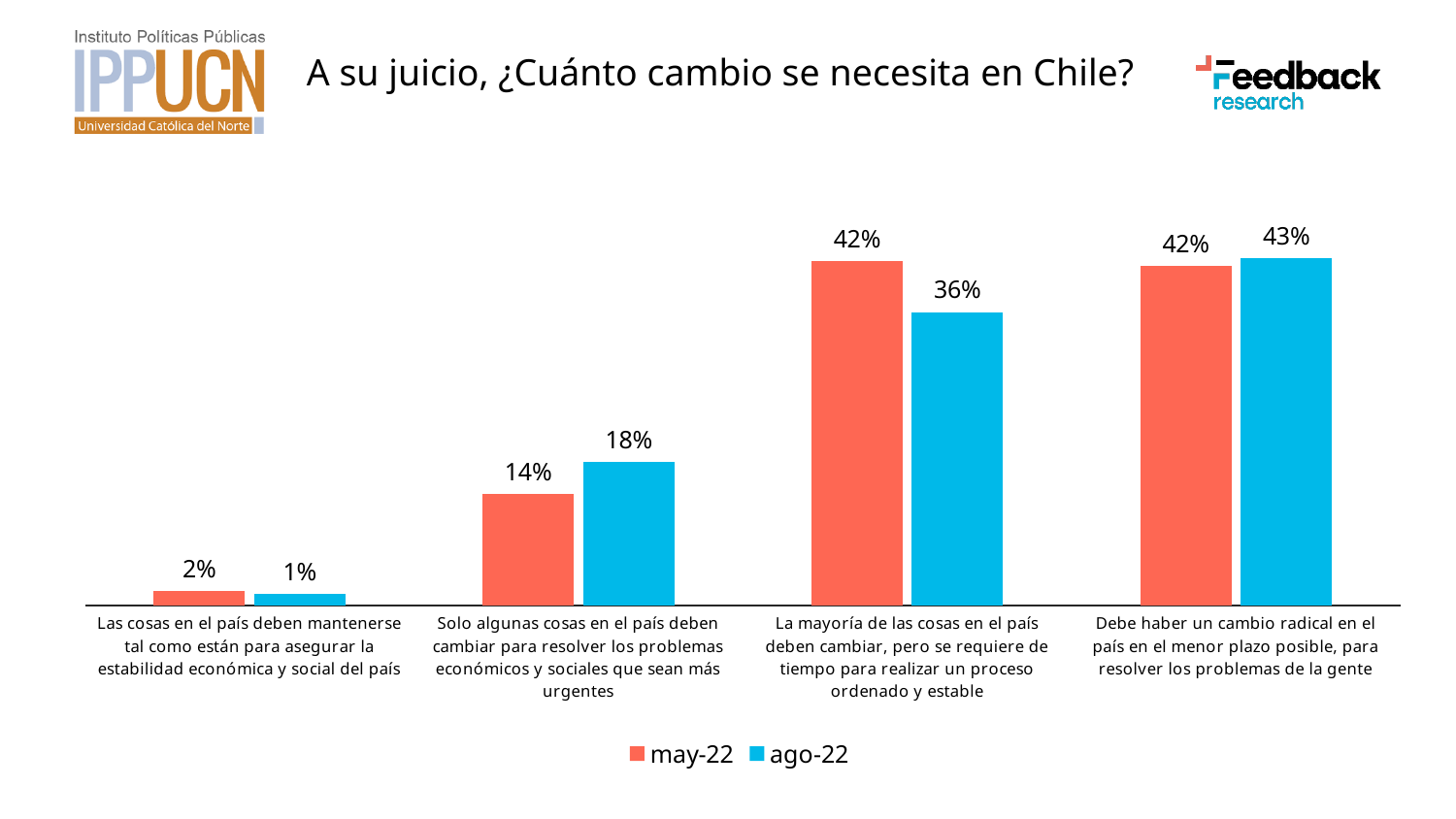
What is the ago-22 value for 'La mayoría de las cosas en el país deben cambiar, pero se requiere de tiempo para realizar un proceso ordenado y estable'? 36% What is the may-22 value for 'Debe haber un cambio radical en el país en el menor plazo posible, para resolver los problemas de la gente'? 42% Which category has the lowest ago-22 value? Las cosas en el país deben mantenerse tal como están para asegurar la estabilidad económica y social del país What is the difference between the may-22 and ago-22 values for 'La mayoría de las cosas en el país deben cambiar, pero se requiere de tiempo para realizar un proceso ordenado y estable'? 6% How many series does the legend list? 2 What is the title of the chart? A su juicio, ¿Cuánto cambio se necesita en Chile? Which category has the highest ago-22 value? Debe haber un cambio radical en el país en el menor plazo posible, para resolver los problemas de la gente For 'Solo algunas cosas en el país deben cambiar para resolver los problemas económicos y sociales que sean más urgentes', which series has the larger value, may-22 or ago-22? ago-22 What kind of chart is shown on the slide? Bar chart Which series is shown in blue in the legend? ago-22 How many categories are shown on the x axis? 4 What is the ago-22 value for 'Solo algunas cosas en el país deben cambiar para resolver los problemas económicos y sociales que sean más urgentes'? 18%